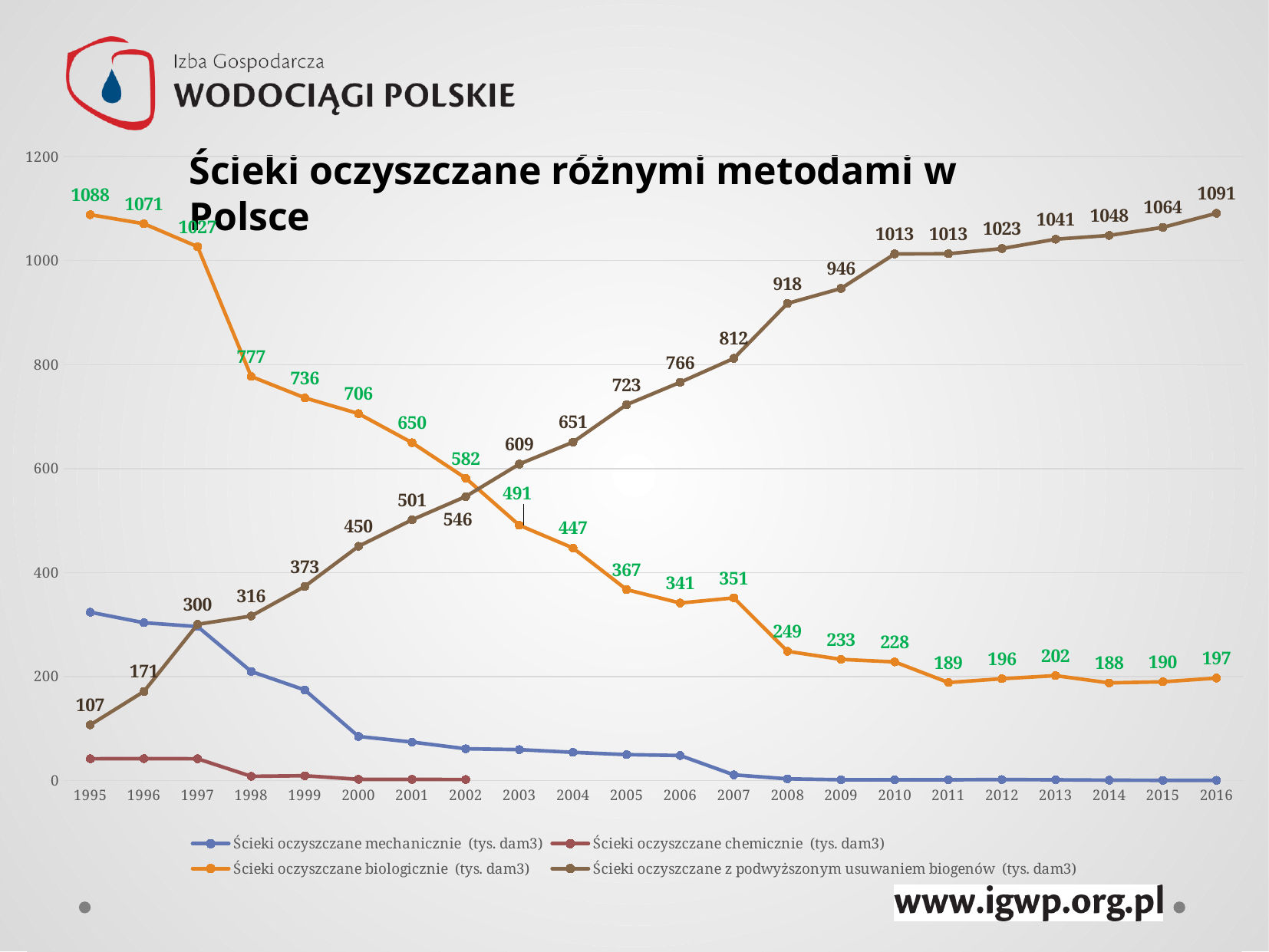
How many series does the legend list? 4 What is the value for Ścieki oczyszczane biologicznie in 2007? 351 Does the value for Ścieki oczyszczane biologicznie generally rise or fall from 1995 to 2016? fall What type of chart is shown on the slide? line chart What is the value for Ścieki oczyszczane biologicznie in 1995? 1088 How many years are shown on the x axis? 22 What is the difference between the 2016 and 1995 values for Ścieki oczyszczane z podwyższonym usuwaniem biogenów? 984 Is the value for Ścieki oczyszczane mechanicznie in 1995 greater or less than 200? greater What is the value for Ścieki oczyszczane z podwyższonym usuwaniem biogenów in 2016? 1091 In which year is the value for Ścieki oczyszczane biologicznie highest? 1995 In 2003, which series has the larger value: Ścieki oczyszczane biologicznie or Ścieki oczyszczane z podwyższonym usuwaniem biogenów? Ścieki oczyszczane z podwyższonym usuwaniem biogenów In which year is the value for Ścieki oczyszczane z podwyższonym usuwaniem biogenów lowest? 1995